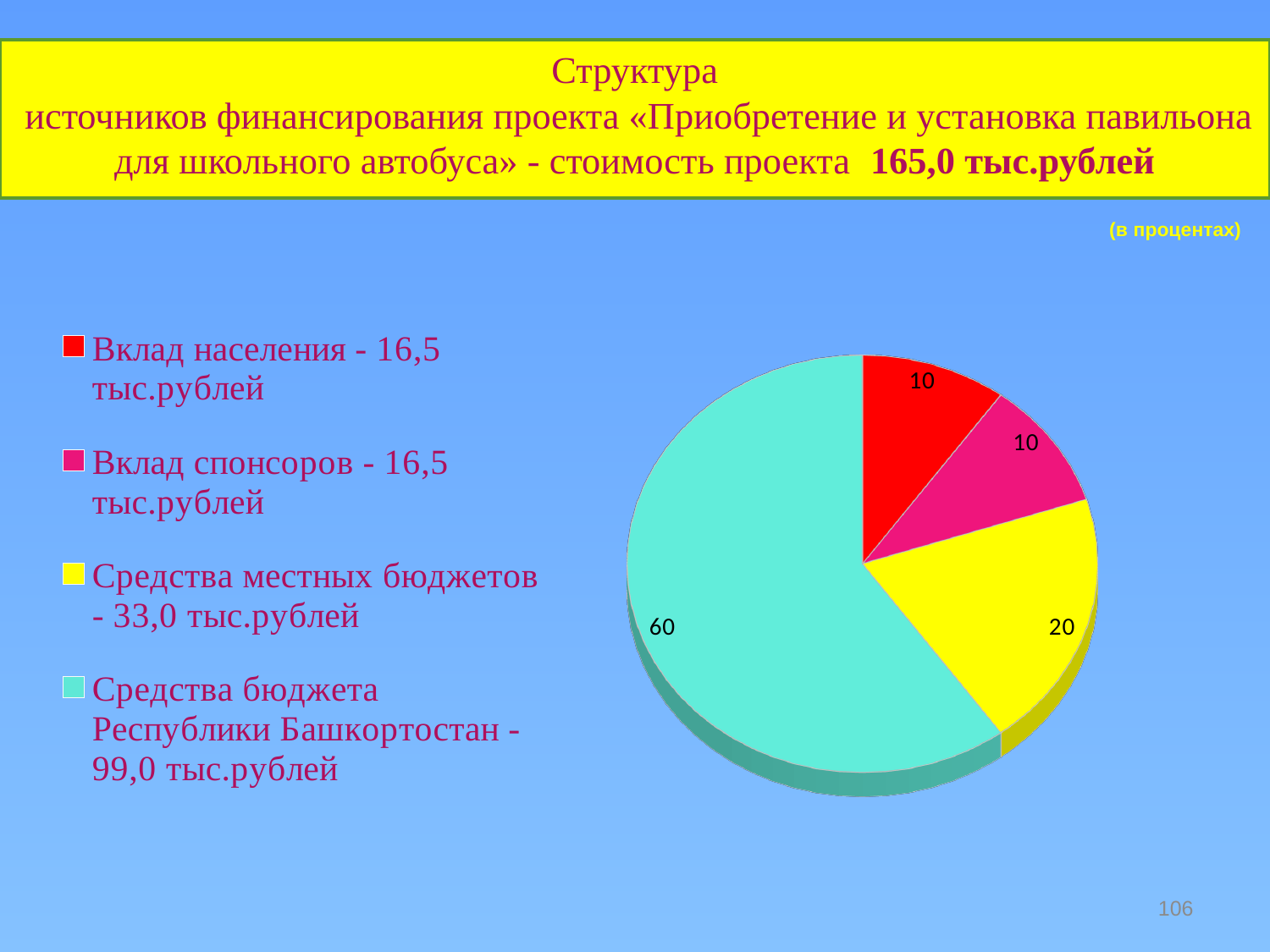
How many slices does the pie chart have? 4 What percentage does the slice for «Средства бюджета Республики Башкортостан» show? 60 What is the total project cost stated in the slide title? 165,0 тыс.рублей What percentage does the slice for «Вклад населения» show? 10 Which funding source has the largest share of the pie? Средства бюджета Республики Башкортостан What colour is the slice for «Средства местных бюджетов»? yellow What percentage does the slice for «Средства местных бюджетов» show? 20 What kind of chart is shown on the slide? pie chart How many entries does the legend list? 4 Which is larger: the share for «Средства местных бюджетов» or the share for «Вклад населения»? Средства местных бюджетов What percentage does the slice for «Вклад спонсоров» show? 10 What is the difference in percentage points between the «Средства бюджета Республики Башкортостан» slice and the «Средства местных бюджетов» slice? 40